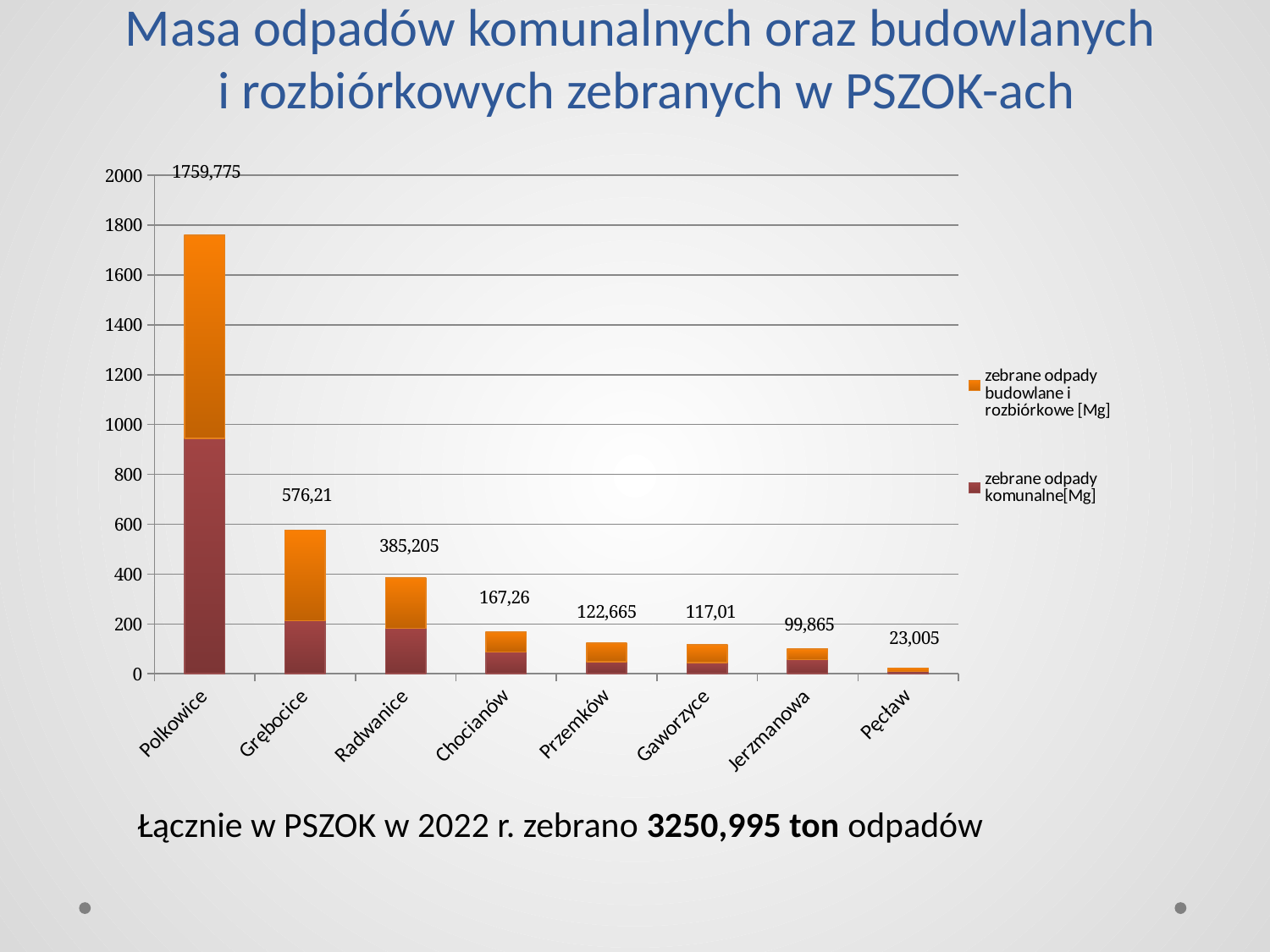
Do the labelled totals rise or fall from left to right along the x axis? fall Which municipality has the highest total mass of collected waste? Polkowice Which municipality has the lowest total mass of collected waste? Pęcław How many series does the legend list? 2 Which has a larger labelled total, Chocianów or Jerzmanowa? Chocianów What is the total value labelled for Polkowice? 1759,775 What kind of chart is shown on the slide? stacked bar chart What is the difference between the labelled totals for Polkowice and Grębocice? 1183,565 Is the value of 'zebrane odpady komunalne[Mg]' for Polkowice greater or less than 800? greater What is the total value labelled for Pęcław? 23,005 How many municipalities are shown on the x axis? 8 What is the total value labelled for Radwanice? 385,205